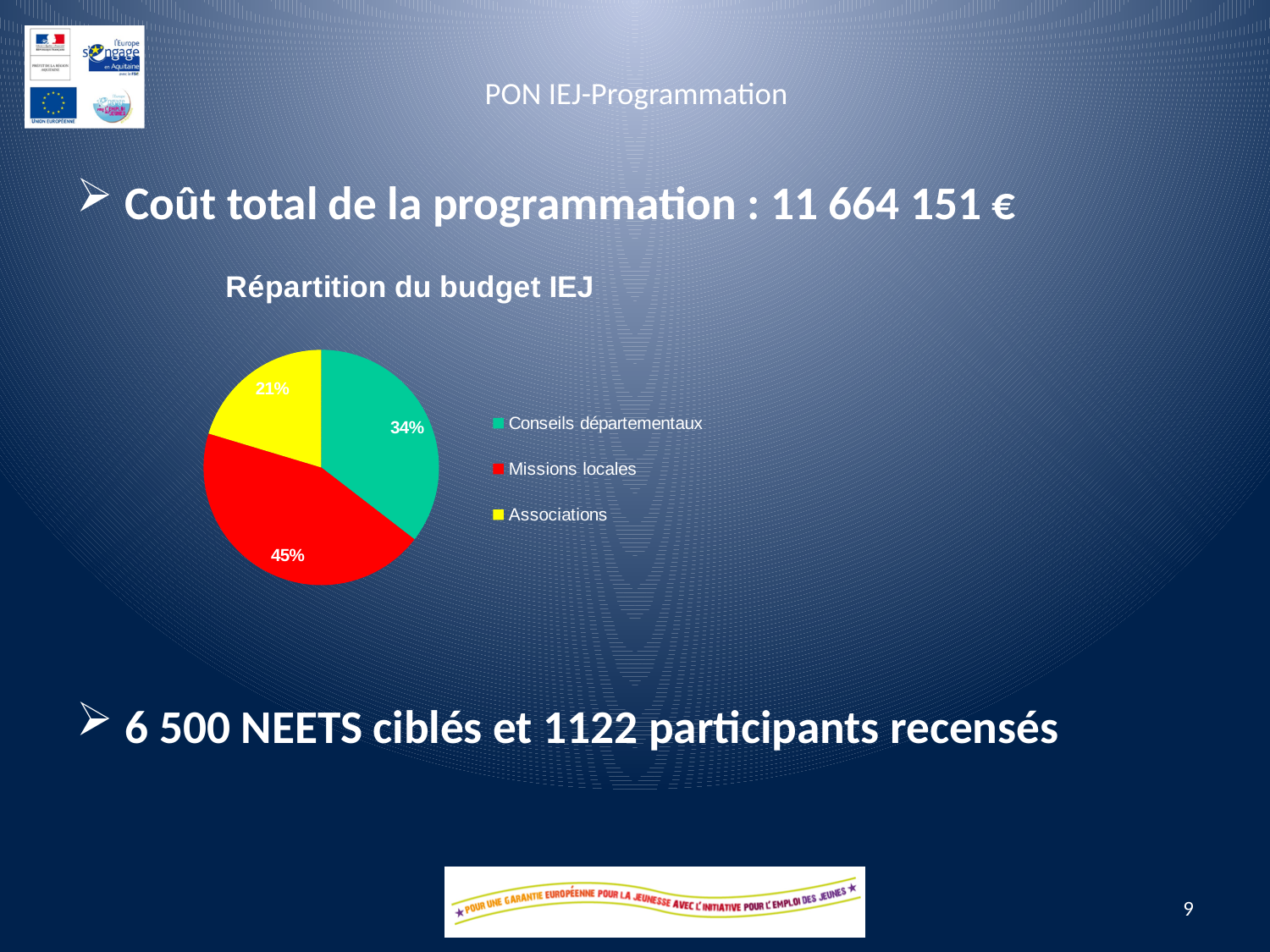
What kind of chart is shown on the slide? pie chart What colour represents Missions locales in the pie chart? red What share of the IEJ budget goes to Conseils départementaux? 34% How many categories does the pie chart show? 3 What is the title of the chart? Répartition du budget IEJ Which is larger, the share for Conseils départementaux or the share for Associations? Conseils départementaux What is the difference in percentage points between the Conseils départementaux share and the Associations share? 13 What is the difference in percentage points between the Missions locales share and the Conseils départementaux share? 11 What share of the IEJ budget goes to Associations? 21% Which category has the largest share of the IEJ budget? Missions locales Which category has the smallest share of the IEJ budget? Associations What share of the IEJ budget goes to Missions locales? 45%